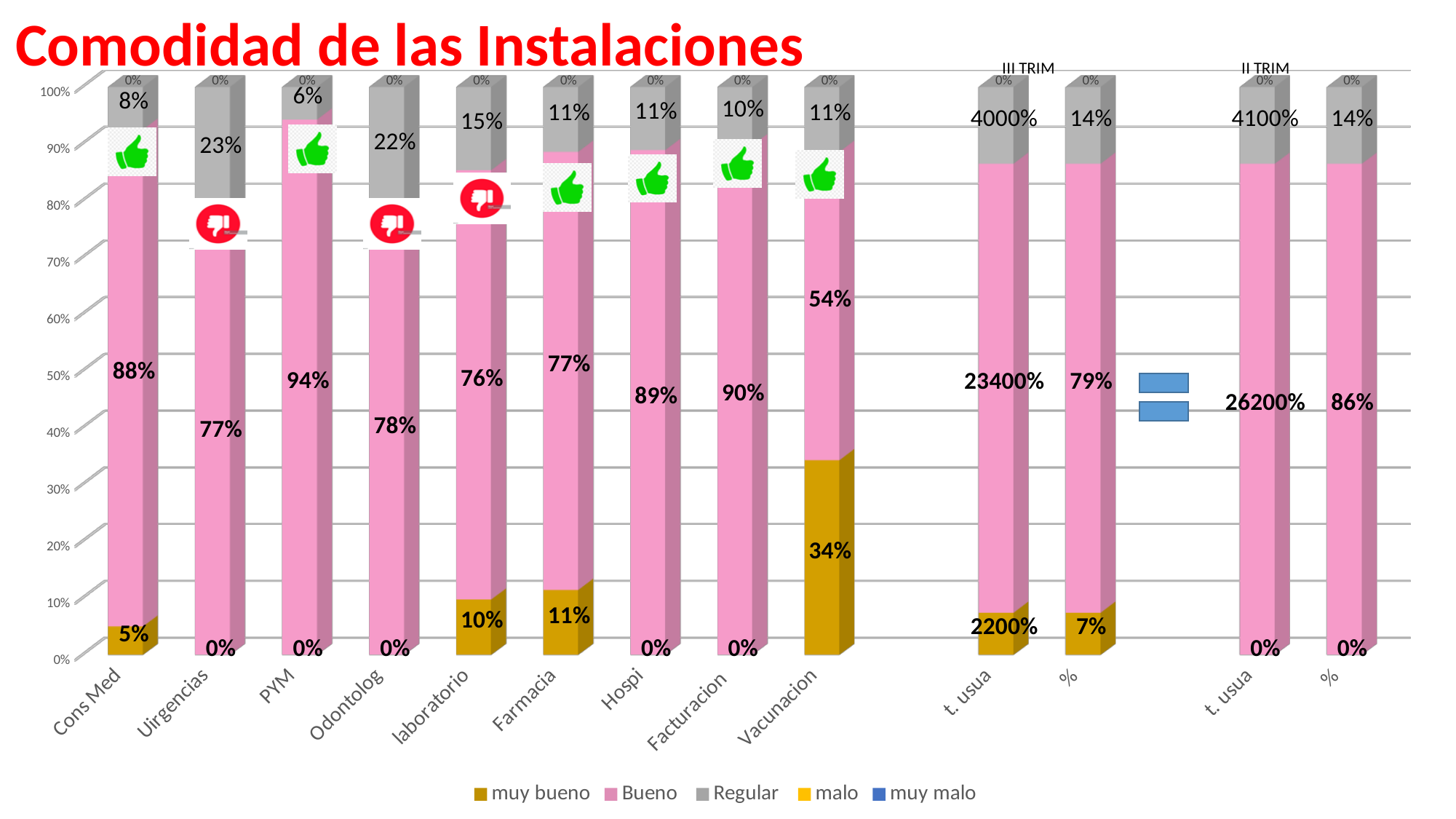
Among the service categories from Cons Med to Vacunacion, which has the lowest Bueno value? Vacunacion What is the difference between the Bueno values for Facturacion and Hospi? 1% How many series does the legend list? 5 What is the difference between the Regular values for Uirgencias and PYM? 17% What is the Bueno value for PYM? 94% What is the muy bueno value for Vacunacion? 34% Which has a larger muy bueno value, Farmacia or laboratorio? Farmacia What kind of chart is shown on the slide? stacked bar chart What is the Bueno value for laboratorio? 76% What is the Regular value for Uirgencias? 23% Among the service categories from Cons Med to Vacunacion, which has the highest Bueno value? PYM What is the title of the slide? Comodidad de las Instalaciones